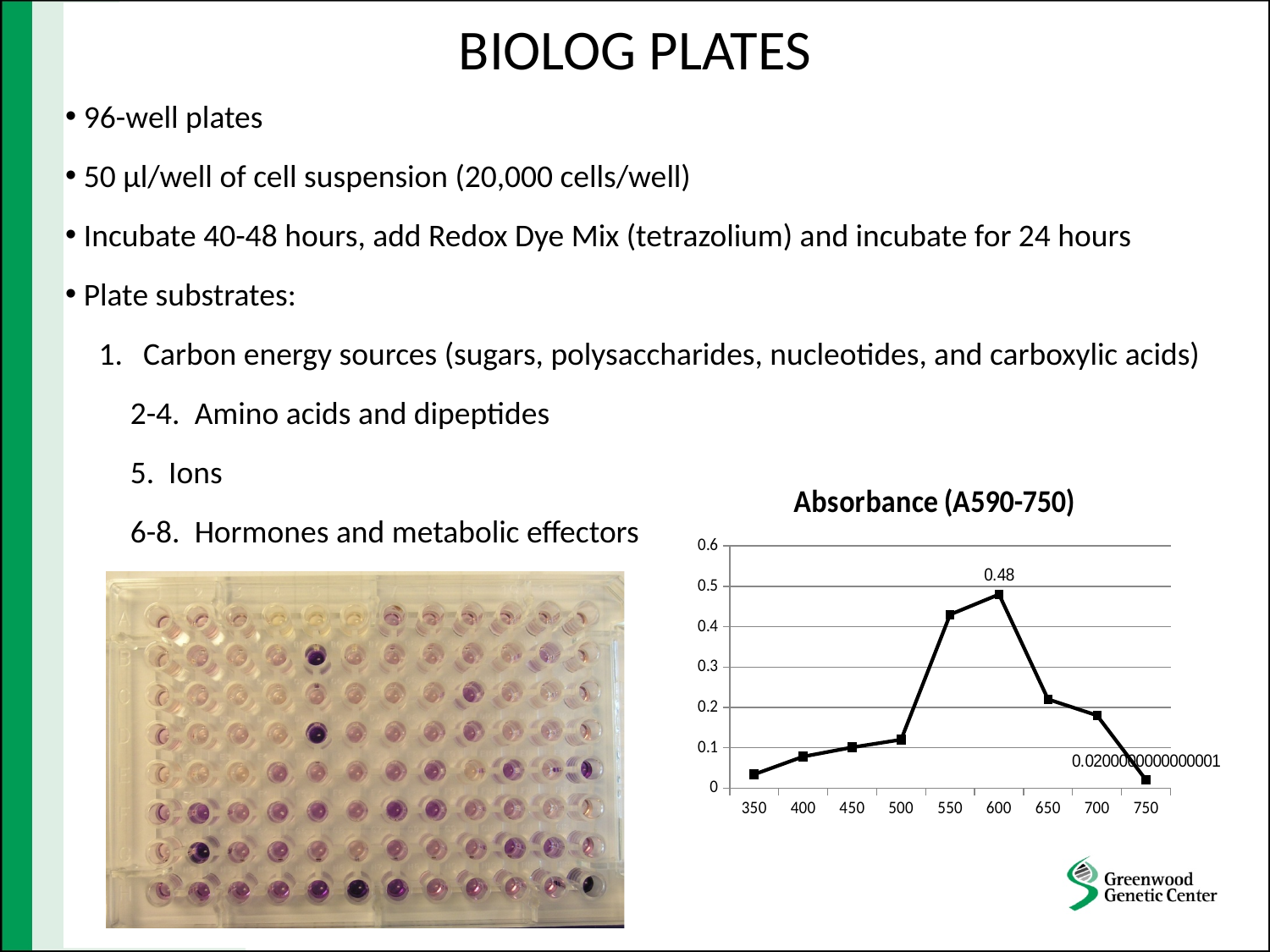
At which x-axis value does the Absorbance (A590-750) chart reach its highest point? 600 Does the absorbance rise or fall from 600 to 750 in the Absorbance (A590-750) chart? fall Which has the higher absorbance, 550 or 650? 550 What value is labelled at 750 in the Absorbance (A590-750) chart? 0.0200000000000001 What kind of chart is the Absorbance (A590-750) chart? line chart What is the title of the line chart on the slide? Absorbance (A590-750) How many data points are plotted in the Absorbance (A590-750) chart? 9 Is the absorbance value at 350 greater or less than 0.1? less What is the absorbance value at 600 in the Absorbance (A590-750) chart? 0.48 Is the absorbance value at 550 greater or less than 0.4? greater Is the absorbance value at 650 greater or less than 0.3? less At which x-axis value is the absorbance lowest in the Absorbance (A590-750) chart? 750